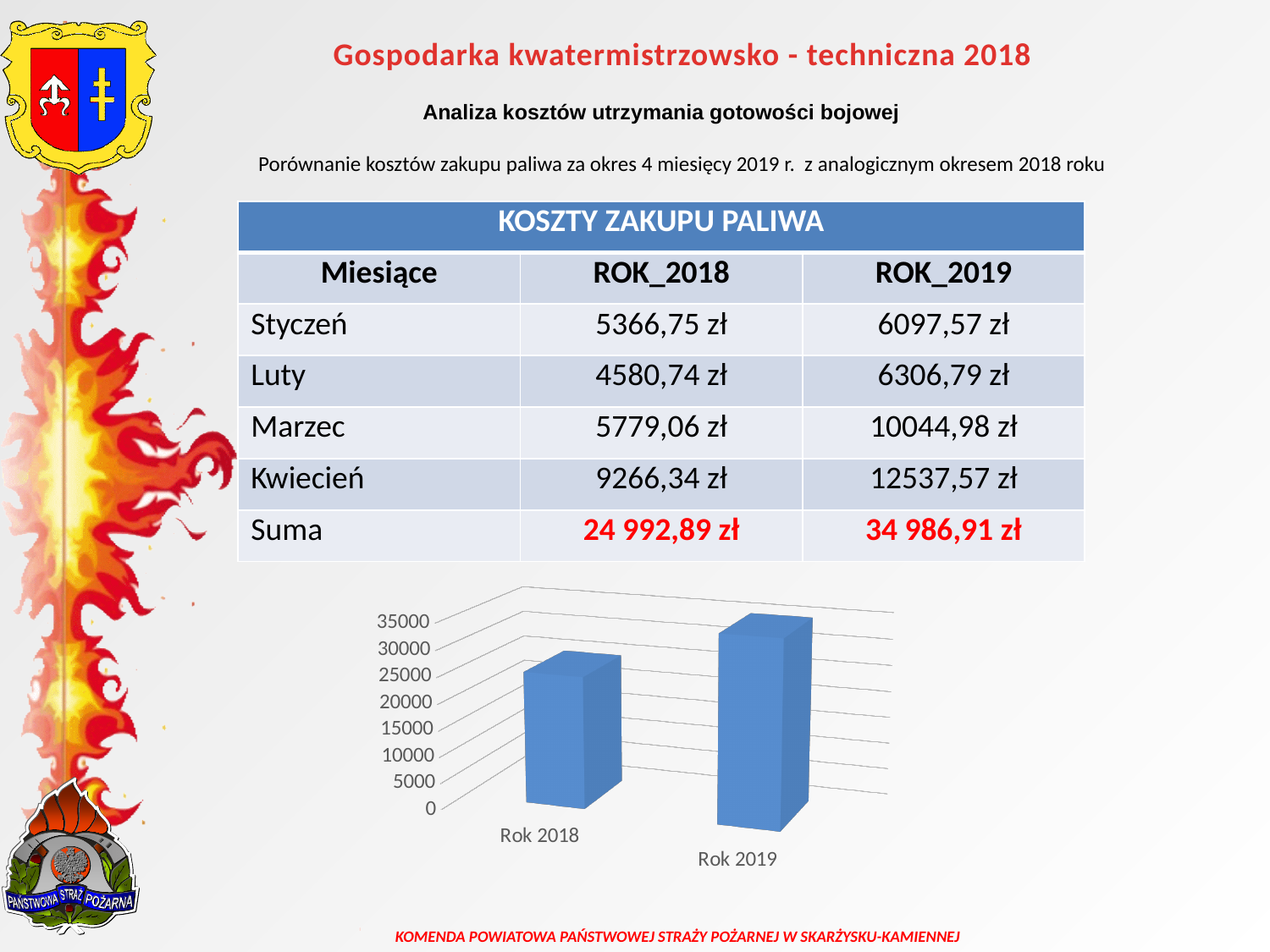
How many bars are plotted in the chart? 2 What kind of chart is shown at the bottom of the slide? bar chart Do the bar values rise or fall from Rok 2018 to Rok 2019? rise Which category has the highest bar in the chart? Rok 2019 Which bar is taller, Rok 2018 or Rok 2019? Rok 2019 Is the value for Rok 2018 greater or less than 30000? less Is the value for Rok 2019 greater or less than 30000? greater Is the value for Rok 2018 greater or less than 20000? greater Which category has the lowest bar in the chart? Rok 2018 What is the highest tick value shown on the vertical axis of the chart? 35000 What colour are the bars in the chart? blue